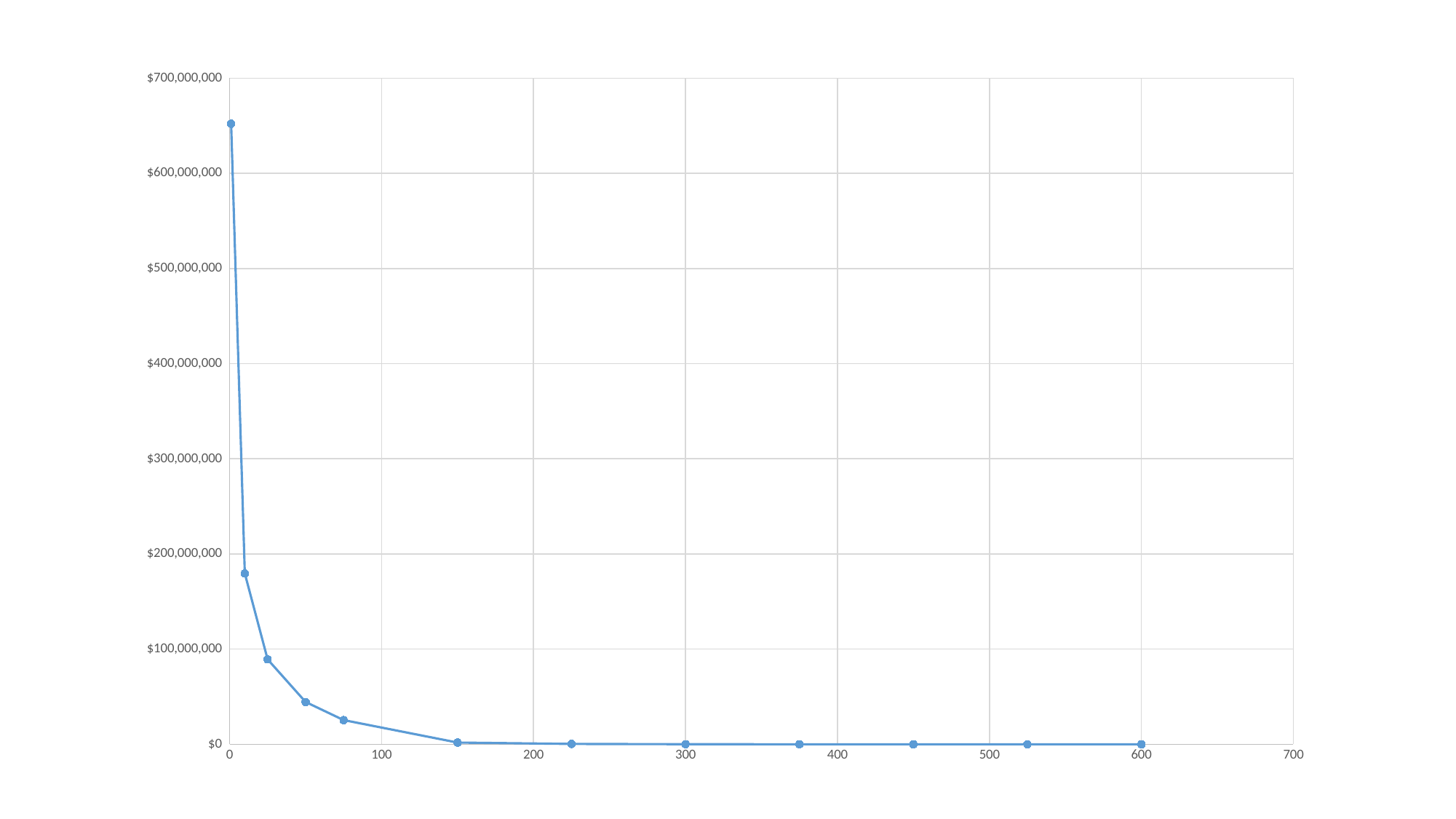
What is the highest tick label shown on the x-axis? 700 Is the value at x = 0 greater or less than $600,000,000? greater What kind of chart is shown on the slide? line chart Do the plotted values rise or fall as the x-axis value increases? fall Is the value at x = 10 greater or less than $100,000,000? greater Is the value at x = 50 greater or less than $100,000,000? less How many data points are plotted on the line? 12 Which has the larger value, the point at x = 10 or the point at x = 50? x = 10 What is the highest tick label shown on the y-axis? $700,000,000